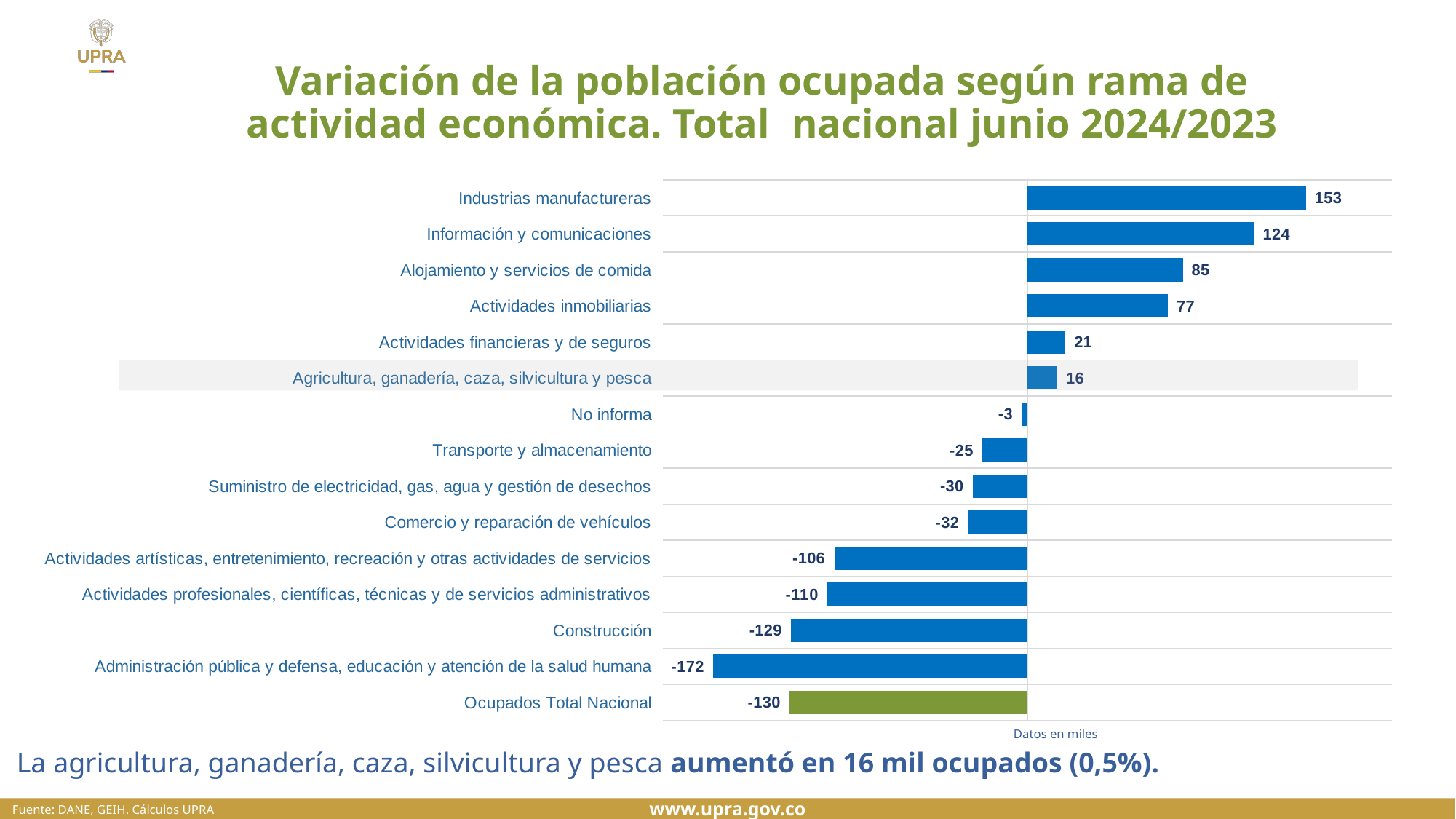
Which is larger, the value for Alojamiento y servicios de comida or the value for Actividades inmobiliarias? Alojamiento y servicios de comida What is the value for Construcción? -129 What is the value for Transporte y almacenamiento? -25 Which category has the lowest value? Administración pública y defensa, educación y atención de la salud humana What is the difference between the values for Industrias manufactureras and Información y comunicaciones? 29 What is the value for Industrias manufactureras? 153 Which bar is shown in a different colour (green) from the others? Ocupados Total Nacional What is the value for Ocupados Total Nacional? -130 What kind of chart is shown on the slide? Bar chart What is the value for Agricultura, ganadería, caza, silvicultura y pesca? 16 How many categories are shown in the chart? 15 Which category has the highest value? Industrias manufactureras